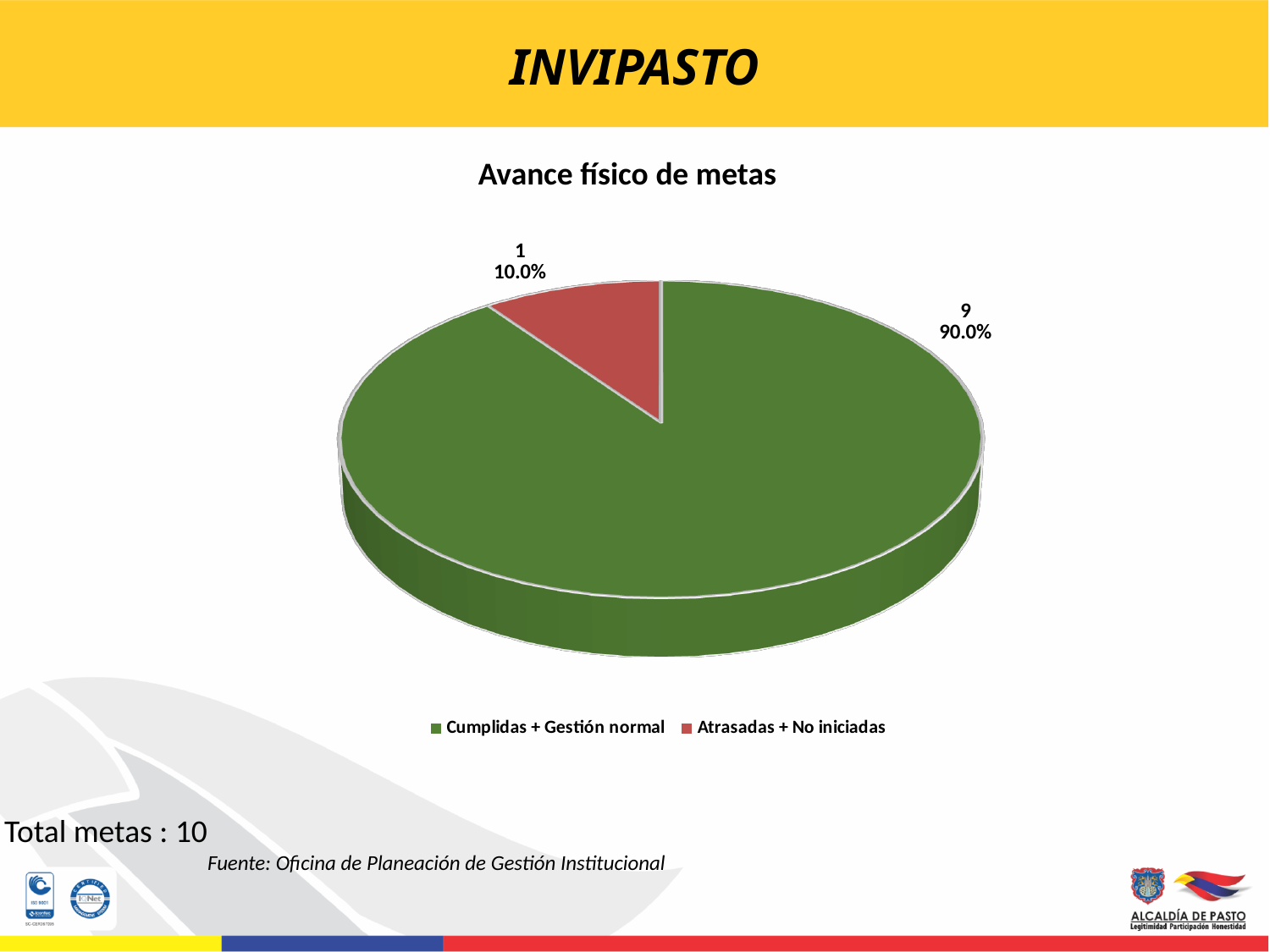
What is the value for Cumplidas + Gestión normal? 9 Which category has the largest slice? Cumplidas + Gestión normal What share of the pie does Atrasadas + No iniciadas represent? 10.0% What colour is the slice for Atrasadas + No iniciadas? Red What is the difference between the values for Cumplidas + Gestión normal and Atrasadas + No iniciadas? 8 How many entries does the legend list? 2 What is the title of the chart? Avance físico de metas How many slices does the pie chart have? 2 What kind of chart is shown on the slide? Pie chart What is the value for Atrasadas + No iniciadas? 1 Which category has the smallest slice? Atrasadas + No iniciadas What share of the pie does Cumplidas + Gestión normal represent? 90.0%